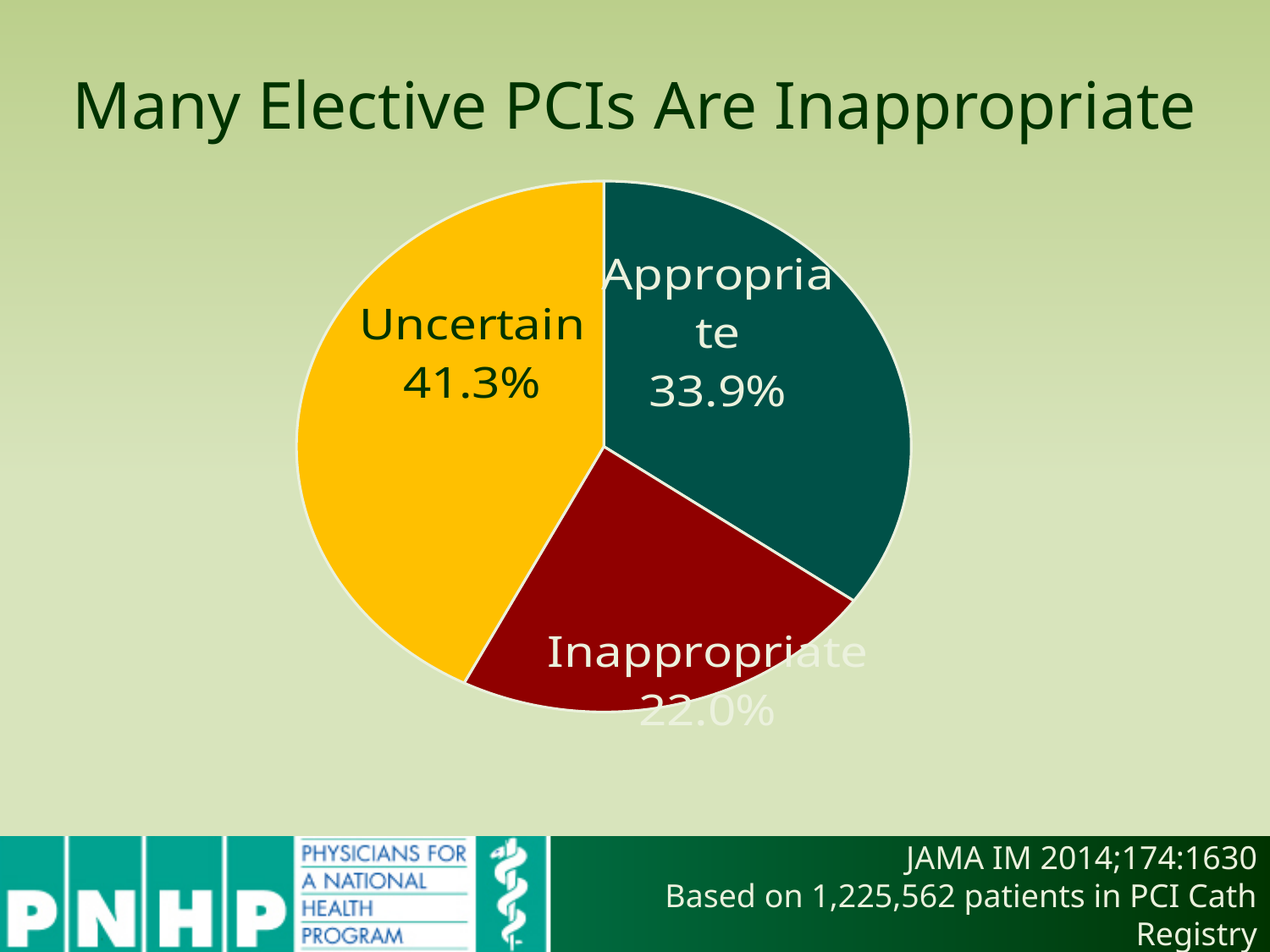
What percentage of elective PCIs are labelled Appropriate? 33.9% Which category has the smallest slice of the pie? Inappropriate What is the difference in percentage points between the Uncertain and Appropriate slices? 7.4 What percentage of elective PCIs are labelled Uncertain? 41.3% How many slices does the pie chart have? 3 What colour is the Inappropriate slice of the pie? Dark red Which is larger, the Appropriate slice or the Inappropriate slice? Appropriate Which category has the largest slice of the pie? Uncertain What is the difference in percentage points between the Appropriate and Inappropriate slices? 11.9 What kind of chart is shown on the slide? Pie chart What is the title of the slide containing the pie chart? Many Elective PCIs Are Inappropriate What percentage of elective PCIs are labelled Inappropriate? 22.0%